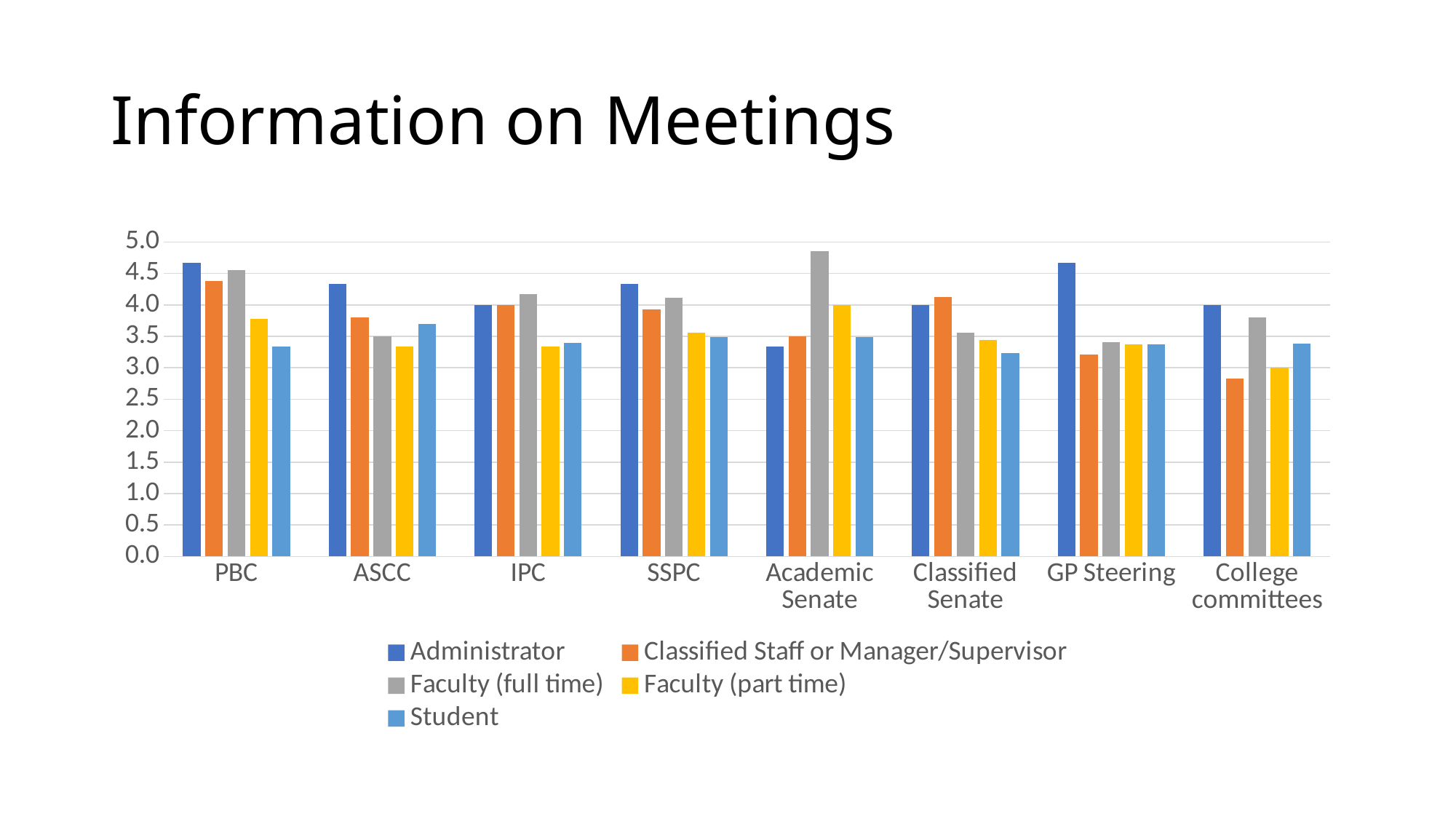
What is the title of the chart? Information on Meetings Which category has the highest Faculty (full time) value? Academic Senate Is the Administrator value for GP Steering greater or less than 4.5? greater Is the Classified Staff or Manager/Supervisor value for College committees greater or less than 3.0? less How many series does the legend list? 5 How many categories are shown along the x axis? 8 What type of chart is shown on the slide? bar chart For Academic Senate, which series has the highest bar? Faculty (full time) For College committees, which series has the lowest bar? Classified Staff or Manager/Supervisor What is the Administrator value for IPC? 4.0 Is the Student value for PBC greater or less than 3.5? less For PBC, which is larger: the Administrator value or the Student value? Administrator